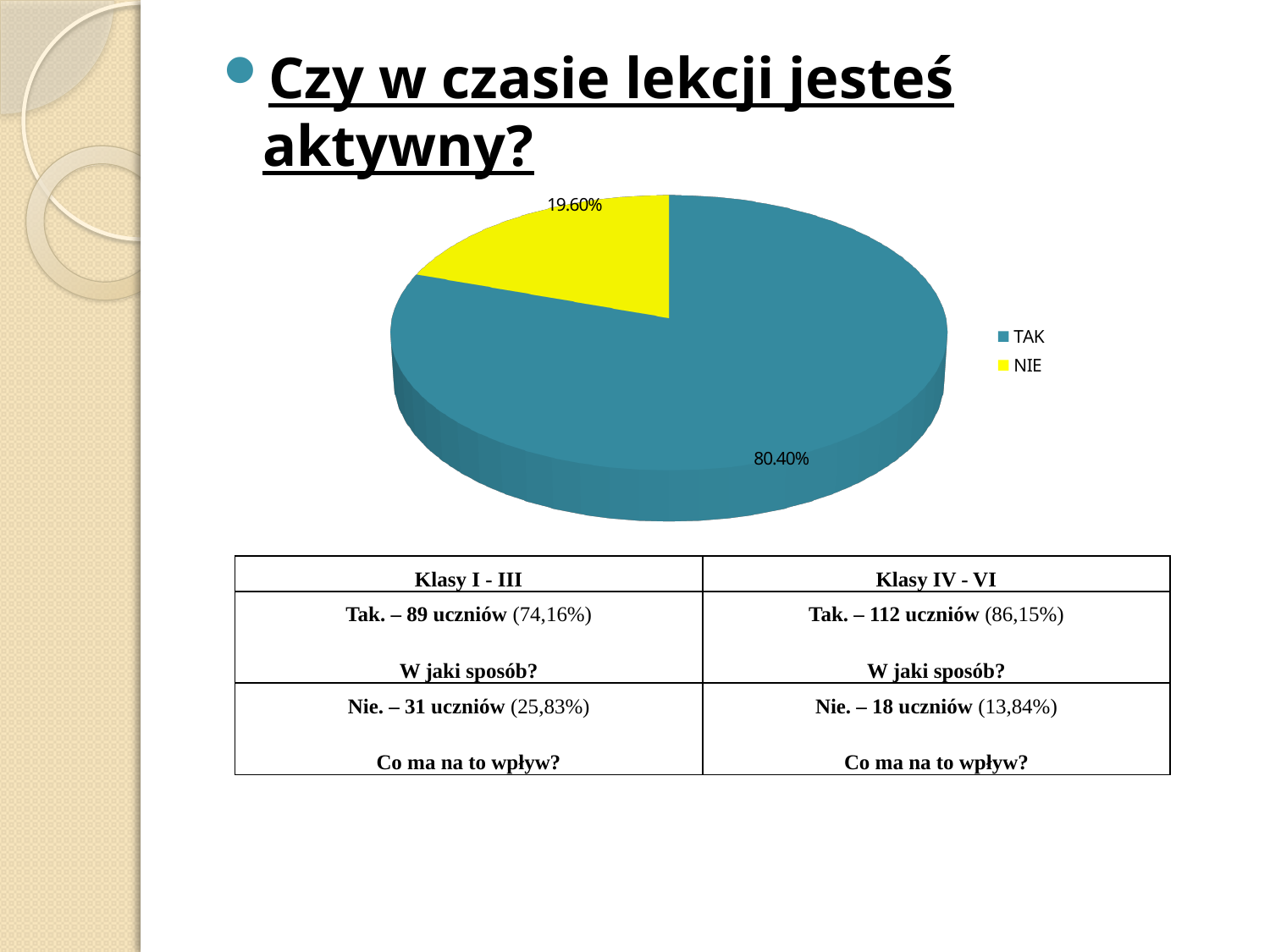
How many entries does the legend list? 2 Which slice is the smallest? NIE How many slices does the pie chart have? 2 What percentage does the NIE slice show? 19.60% What percentage does the TAK slice show? 80.40% What is the difference in percentage points between the TAK and NIE slices? 60.80% What kind of chart is shown on the slide? pie chart What colour is the NIE slice? yellow Which is larger, the TAK slice or the NIE slice? TAK Which slice is the largest? TAK What colour is the TAK slice? teal blue